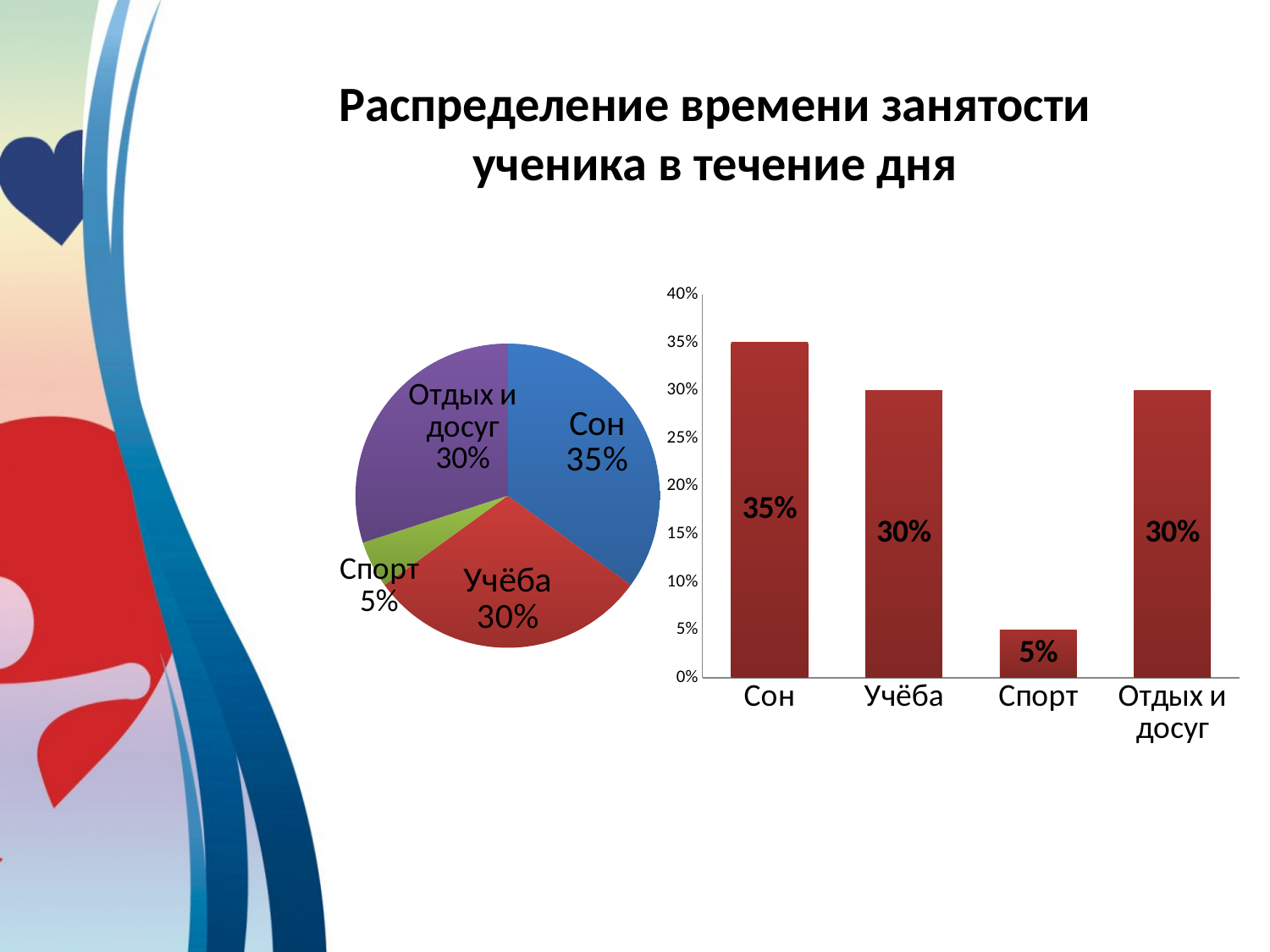
In the pie chart on the left, which category has the smallest slice? Спорт In the bar chart on the right, what is the value for Спорт? 5% In the bar chart on the right, what is the difference between the values for Сон and Спорт? 30% What kind of chart is the chart on the right? bar chart In the bar chart on the right, is the value for Сон greater or less than 30%? greater In the pie chart on the left, what share does Сон have? 35% In the bar chart on the right, which category has the highest value? Сон In the bar chart on the right, which is larger, the value for Учёба or the value for Спорт? Учёба What is the title of the slide? Распределение времени занятости ученика в течение дня What kind of chart is the chart on the left? pie chart In the pie chart on the left, what share does Отдых и досуг have? 30% How many categories are shown in the bar chart on the right? 4